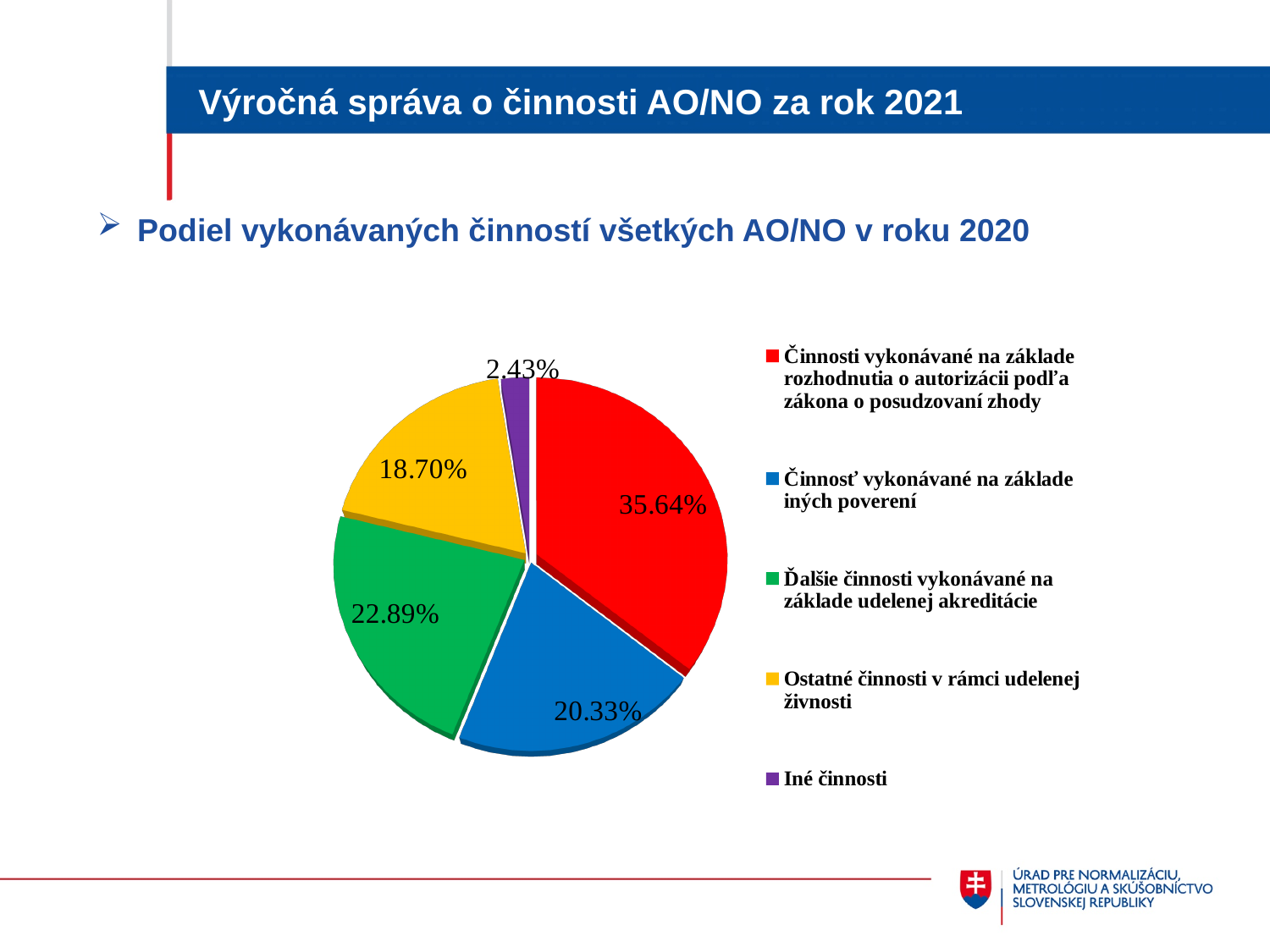
What colour is the slice for "Iné činnosti"? purple What kind of chart is shown on the slide? pie chart What share of the pie does "Činnosť vykonávané na základe iných poverení" have? 20.33% Which is larger: the slice for "Ďalšie činnosti vykonávané na základe udelenej akreditácie" or the slice for "Ostatné činnosti v rámci udelenej živnosti"? Ďalšie činnosti vykonávané na základe udelenej akreditácie What share of the pie does "Ďalšie činnosti vykonávané na základe udelenej akreditácie" have? 22.89% What share of the pie does "Ostatné činnosti v rámci udelenej živnosti" have? 18.70% What share of the pie does "Iné činnosti" have? 2.43% What is the difference in percentage points between the largest slice (35.64%) and the slice for "Činnosť vykonávané na základe iných poverení" (20.33%)? 15.31 How many categories does the legend list? 5 Which category has the largest slice of the pie? Činnosti vykonávané na základe rozhodnutia o autorizácii podľa zákona o posudzovaní zhody What share of the pie does "Činnosti vykonávané na základe rozhodnutia o autorizácii podľa zákona o posudzovaní zhody" have? 35.64% Which category has the smallest slice of the pie? Iné činnosti